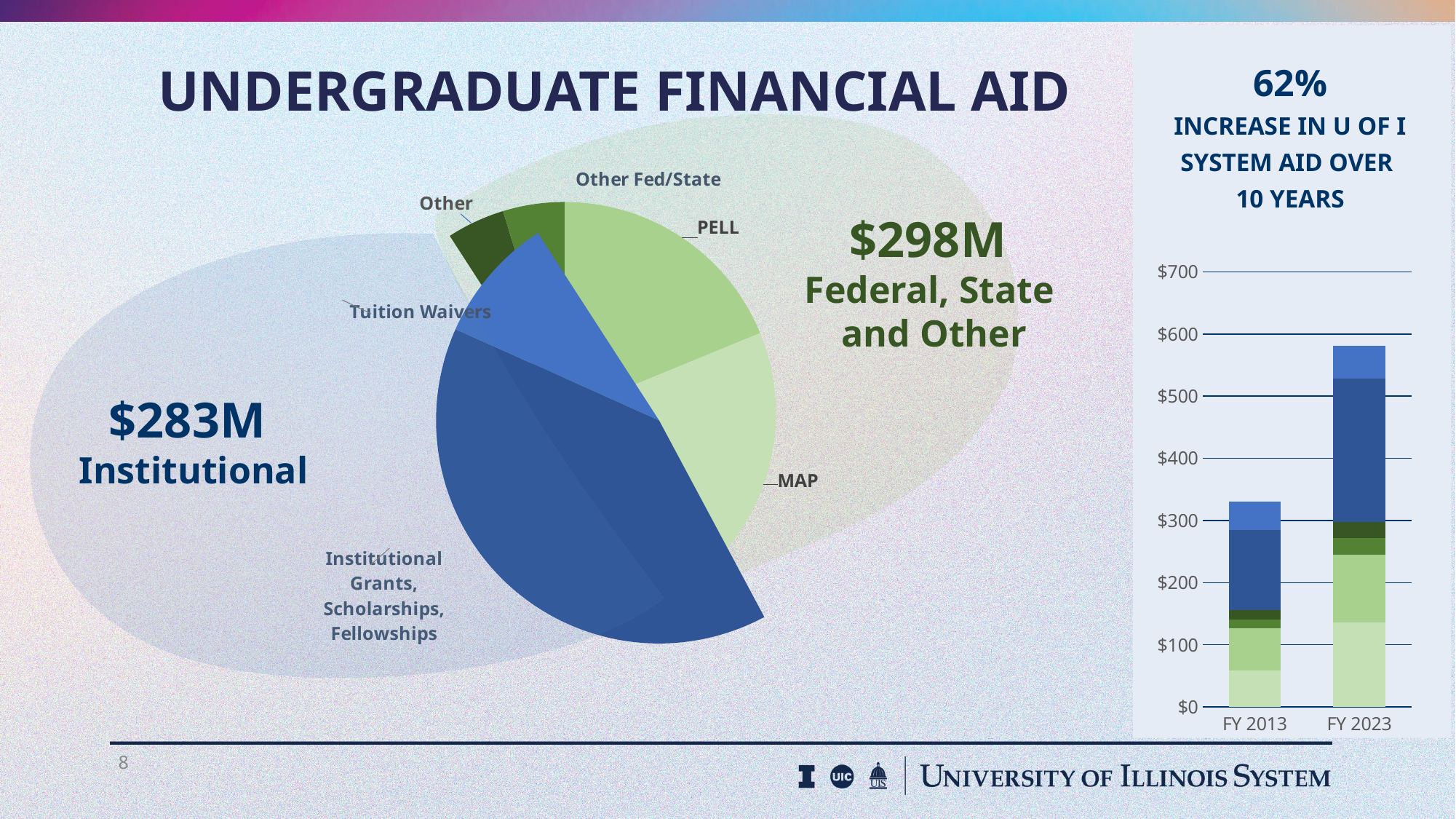
In the pie chart, which slice is larger, Institutional Grants, Scholarships, Fellowships or Tuition Waivers? Institutional Grants, Scholarships, Fellowships In the bar chart on the right, is the total for FY 2023 greater or less than $500? greater In the bar chart on the right, which year has the taller bar, FY 2013 or FY 2023? FY 2023 In the bar chart on the right, do the totals rise or fall from FY 2013 to FY 2023? rise What kind of chart is the chart in the centre of the slide? pie chart What is the title of the slide containing the pie chart? UNDERGRADUATE FINANCIAL AID What kind of chart is the chart on the right side of the slide? bar chart In the bar chart on the right, is the total for FY 2023 greater or less than $600? less Which slice of the pie chart is the largest? Institutional Grants, Scholarships, Fellowships How many slices does the pie chart have? 6 In the bar chart on the right, is the total for FY 2013 greater or less than $400? less How many categories are shown on the x axis of the bar chart on the right? 2